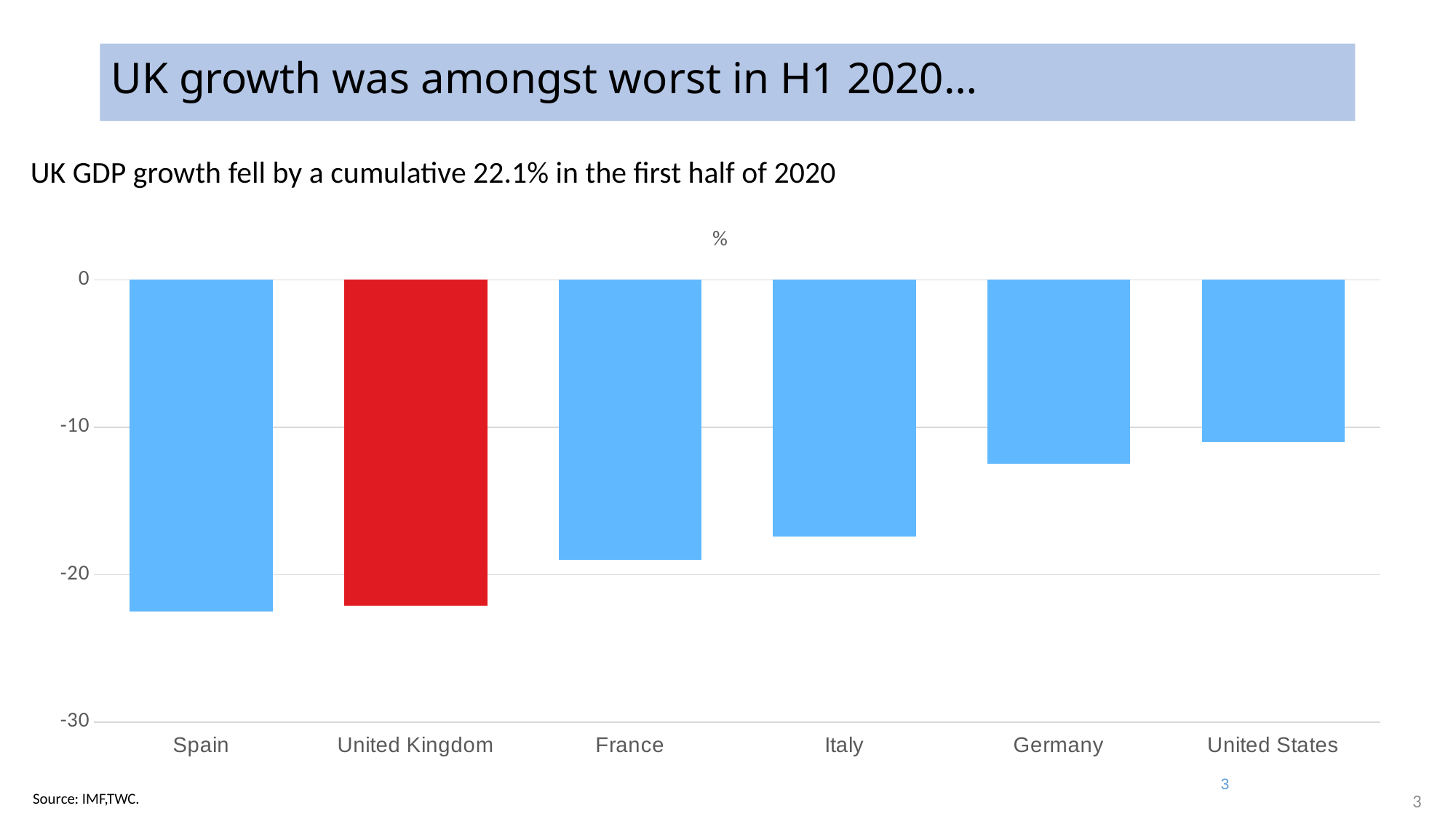
Is the value for France greater or less than -10? less Is the value for Italy greater or less than -20? greater What kind of chart is shown on the slide? bar chart Which has the larger value, France or Italy? Italy Which has the larger value, Germany or Spain? Germany Which country has the highest (least negative) value in the chart? United States Is the value for Germany greater or less than -10? less Which country's bar is coloured red in the chart? United Kingdom How many countries are shown on the x axis of the chart? 6 According to the slide text, by how much did UK GDP growth fall cumulatively in the first half of 2020? 22.1%